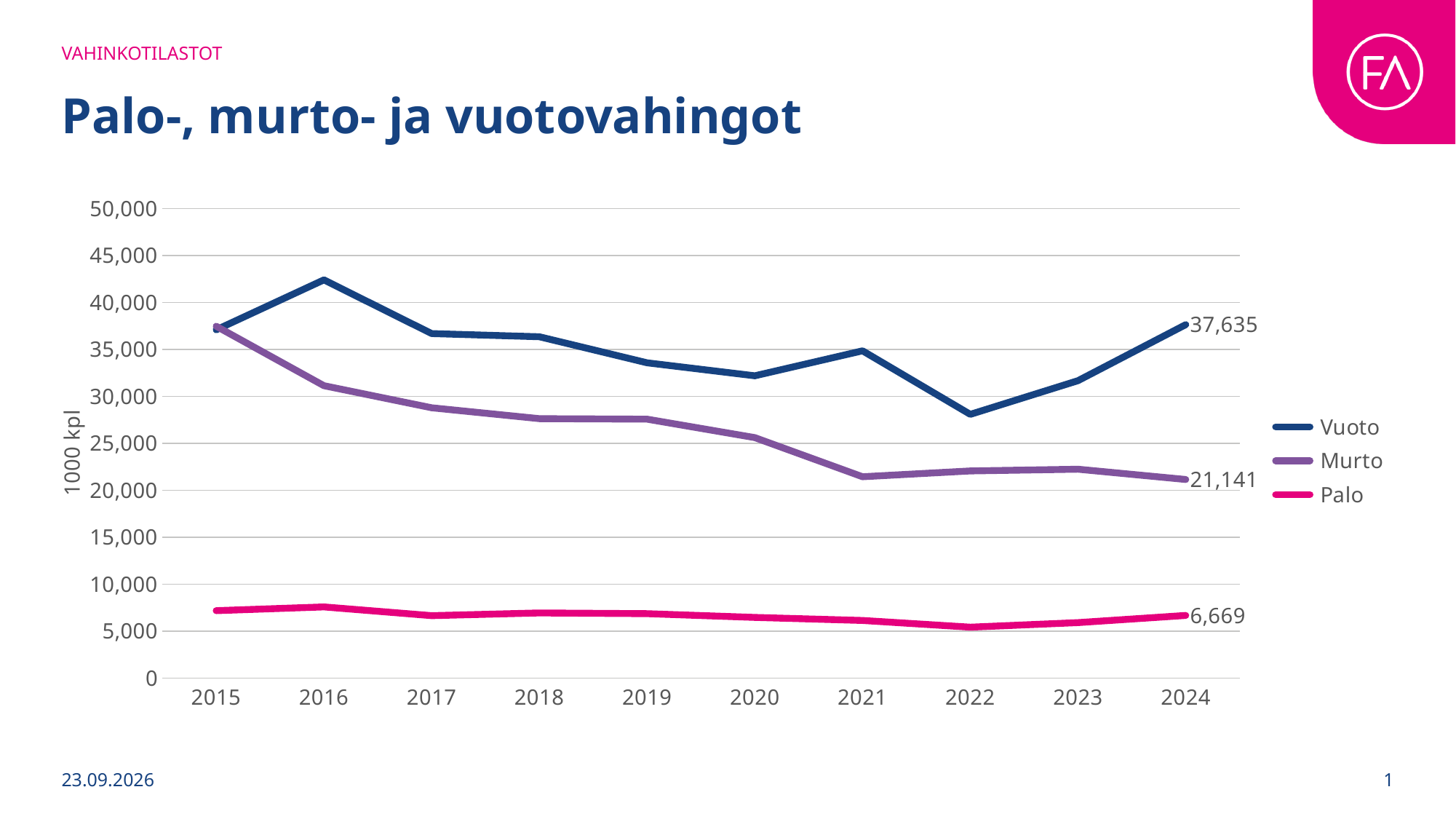
In which year is the Vuoto series at its highest? 2016 Which series has the larger value in 2024, Vuoto or Murto? Vuoto What is the value for Murto in 2024? 21,141 How many years are shown on the x axis? 10 What is the difference between the Vuoto and Murto values in 2024? 16,494 What is the difference between the Murto and Palo values in 2024? 14,472 What kind of chart is shown on the slide? line chart Is the value for Vuoto in 2016 greater or less than 40,000? greater What is the value for Palo in 2024? 6,669 What is the value for Vuoto in 2024? 37,635 How many series does the legend list? 3 In which year is the Vuoto series at its lowest? 2022